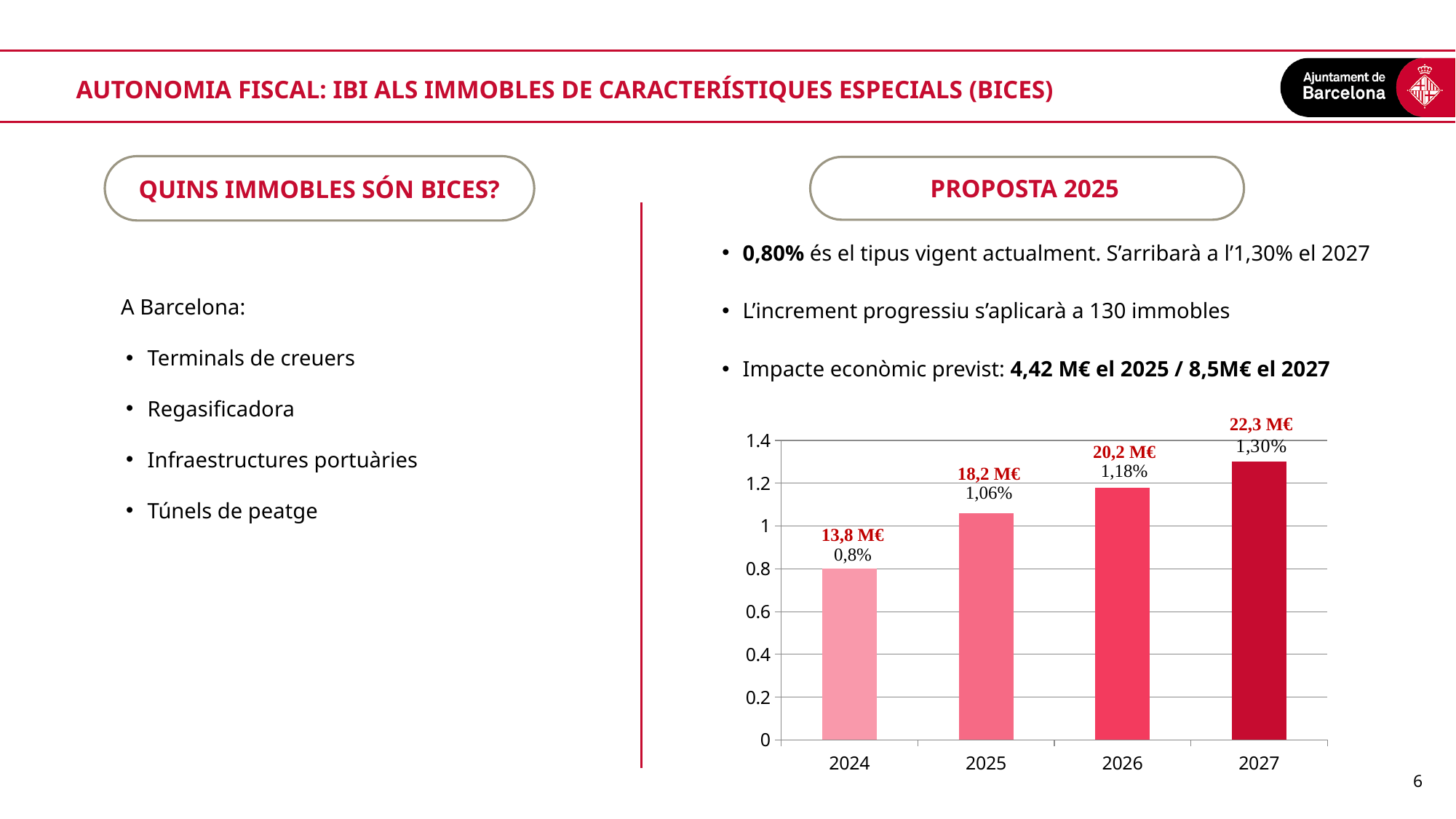
How many bars (years) are plotted in the chart? 4 Do the bar values rise or fall from 2024 to 2027? rise What amount in M€ is labelled above the bar for 2027? 22,3 M€ What is the difference in M€ between the labels for 2027 and 2024? 8,5 M€ Which is larger, the percentage for 2025 or for 2026? 2026 What type of chart is shown on the slide? bar chart What percentage is labelled on the bar for 2026? 1,18% What amount in M€ is labelled above the bar for 2025? 18,2 M€ Which year has the lowest bar in the chart? 2024 Which year has the highest bar in the chart? 2027 Is the value for 2025 greater or less than 1? greater What percentage is labelled on the bar for 2024? 0,8%